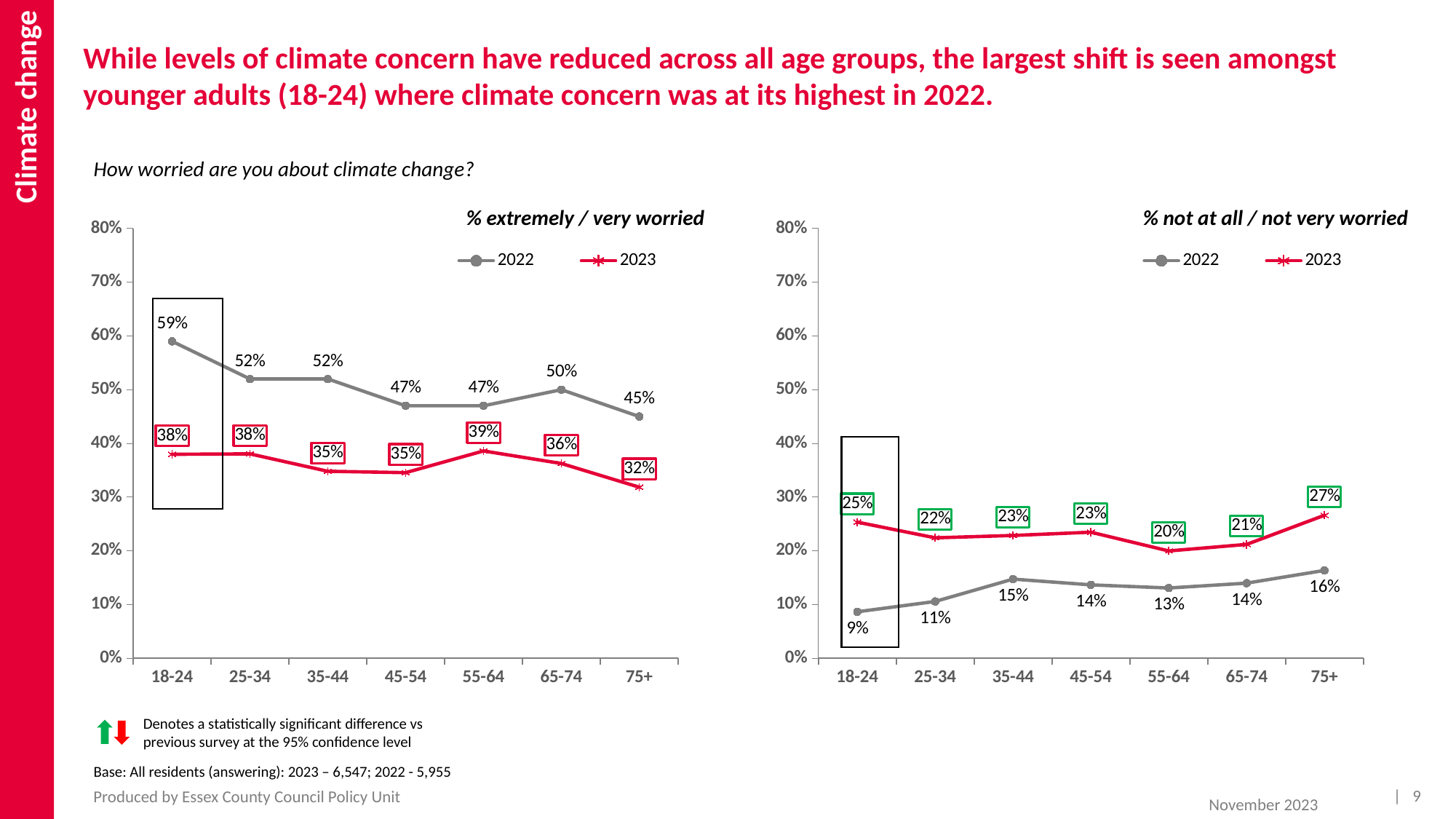
In the '% not at all / not very worried' chart, which age group has the highest 2023 value? 75+ In the '% extremely / very worried' chart, which age group has the highest 2022 value? 18-24 In the '% extremely / very worried' chart, what is the 2022 value for the 18-24 age group? 59% In the '% not at all / not very worried' chart, what is the difference between the 2023 and 2022 values for the 75+ age group? 11 percentage points In the '% extremely / very worried' chart, what is the difference between the 2022 and 2023 values for the 18-24 age group? 21 percentage points How many age groups are shown on the x axis of the '% not at all / not very worried' chart? 7 In the '% extremely / very worried' chart, which is larger for the 65-74 age group: the 2022 value or the 2023 value? 2022 In the '% not at all / not very worried' chart, which age group has the lowest 2022 value? 18-24 In the '% not at all / not very worried' chart, what is the 2023 value for the 55-64 age group? 20% In the '% extremely / very worried' chart, what is the 2023 value for the 75+ age group? 32% How many series does the legend of the '% extremely / very worried' chart list? 2 What type of chart is the '% not at all / not very worried' chart? Line chart